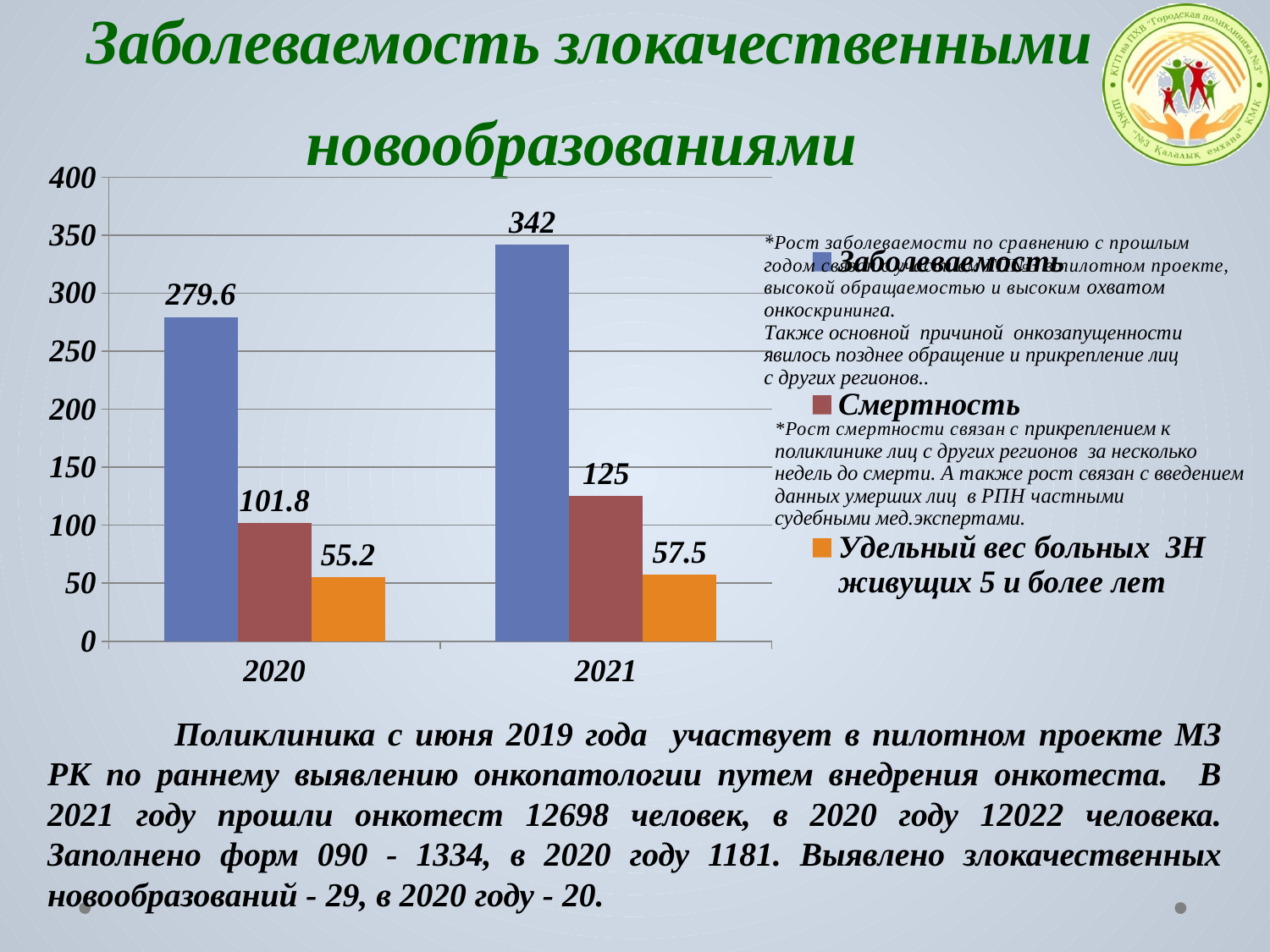
What is the value of Заболеваемость for 2020? 279.6 Is the value of Заболеваемость for 2021 greater or less than 300? greater Which year has the higher value for Смертность, 2020 or 2021? 2021 What is the difference between Смертность in 2021 and in 2020? 23.2 By how much did Заболеваемость increase from 2020 to 2021? 62.4 How many series does the legend list? 3 What is the value of Смертность for 2020? 101.8 Which series has the lowest value in 2020? Удельный вес больных ЗН живущих 5 и более лет What is the value of Заболеваемость for 2021? 342 How many years are shown on the x axis? 2 What type of chart is shown on the slide? Bar chart What is the value of Удельный вес больных ЗН живущих 5 и более лет for 2021? 57.5